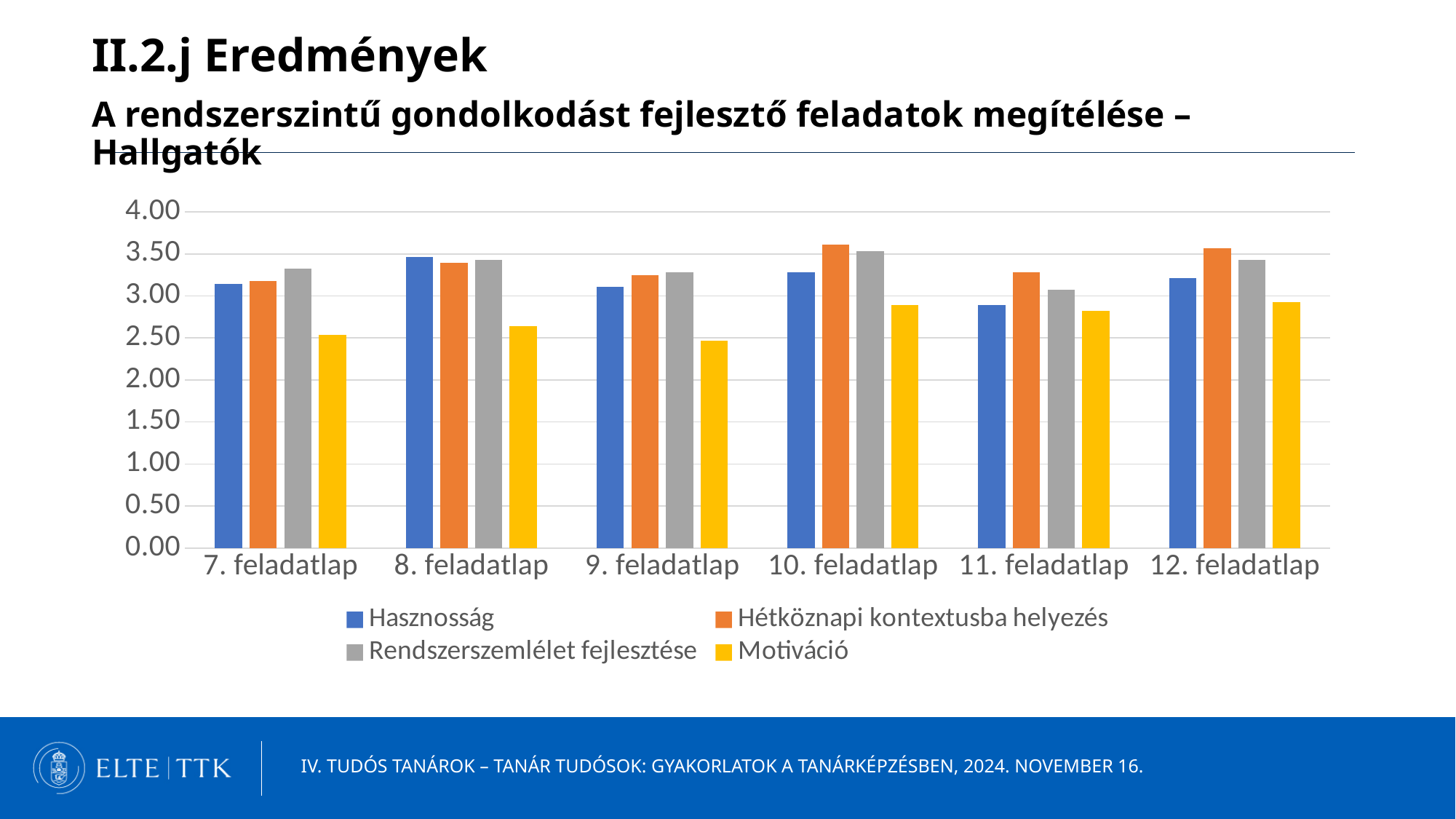
Is the Motiváció value for 7. feladatlap greater or less than 3.00? less Which series has the lowest value for 7. feladatlap? Motiváció For 8. feladatlap, which is larger: Hasznosság or Motiváció? Hasznosság How many series does the legend list? 4 Is the Hasznosság value for 11. feladatlap greater or less than 3.00? less Is the Hétköznapi kontextusba helyezés value for 10. feladatlap greater or less than 3.50? greater Which feladatlap has the lowest Hasznosság value? 11. feladatlap How many feladatlap categories are shown on the x axis? 6 What colour represents the Motiváció series in the legend? yellow What kind of chart is shown on the slide? bar chart For 11. feladatlap, which is larger: Hétköznapi kontextusba helyezés or Hasznosság? Hétköznapi kontextusba helyezés Which feladatlap has the highest Hasznosság value? 8. feladatlap